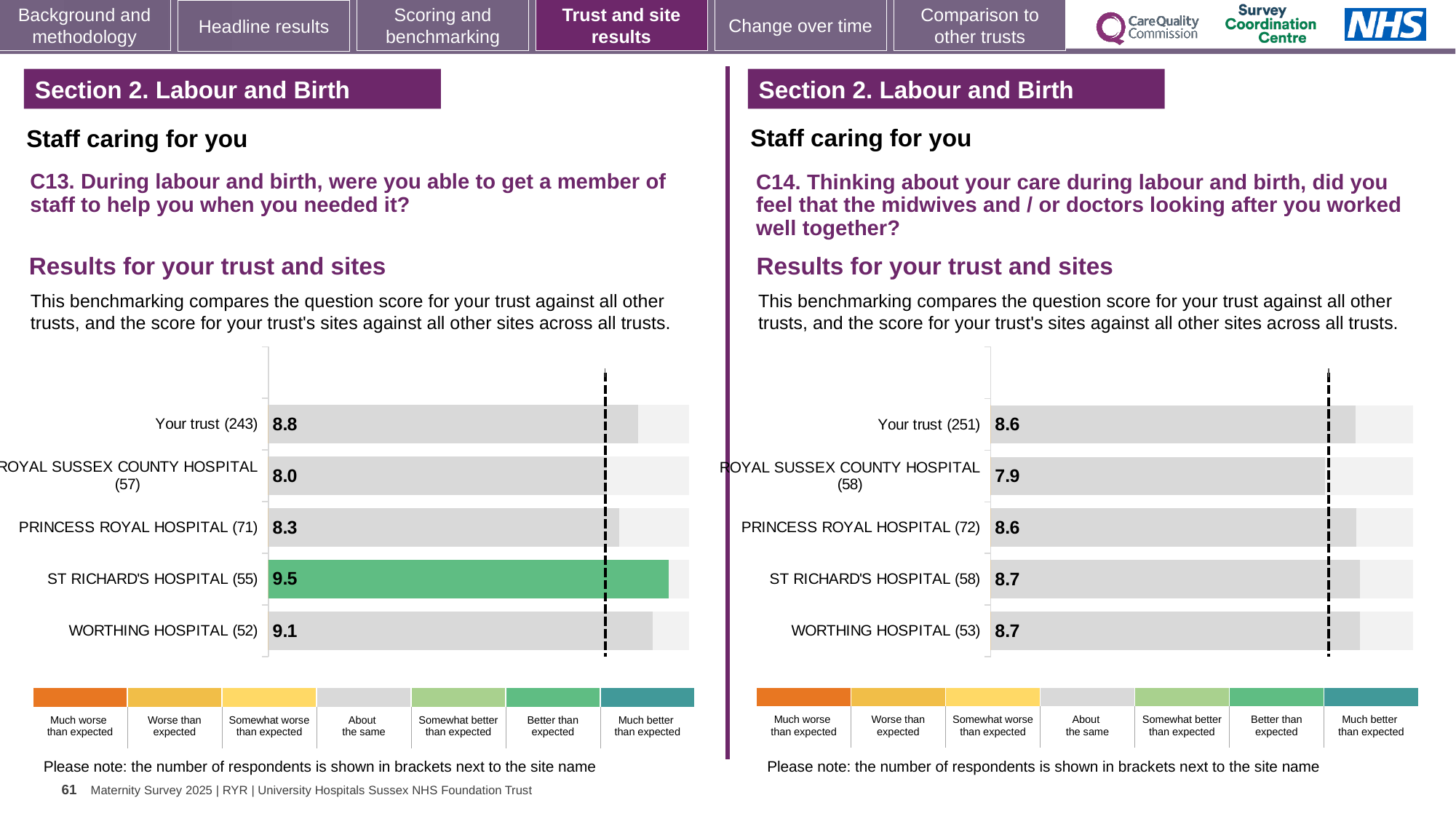
In the C14 chart on the right, what is the score for ROYAL SUSSEX COUNTY HOSPITAL (58)? 7.9 In the C13 chart on the left, what is the difference between the scores for WORTHING HOSPITAL (52) and PRINCESS ROYAL HOSPITAL (71)? 0.8 In the C13 chart on the left, which bar is coloured green rather than grey? ST RICHARD'S HOSPITAL (55) In the C13 chart on the left, which site has the lowest score? ROYAL SUSSEX COUNTY HOSPITAL (57) In the C14 chart on the right, which site has the lowest score? ROYAL SUSSEX COUNTY HOSPITAL (58) In the C14 chart on the right, which is larger: the score for ST RICHARD'S HOSPITAL (58) or PRINCESS ROYAL HOSPITAL (72)? ST RICHARD'S HOSPITAL (58) In the C13 chart on the left, what is the score for ST RICHARD'S HOSPITAL (55)? 9.5 What kind of chart is used in the C13 chart on the left? Bar chart In the C14 chart on the right, what is the score for Your trust (251)? 8.6 In the C13 chart on the left, what is the score for Your trust (243)? 8.8 In the C13 chart on the left, how many bars are plotted? 5 In the C13 chart on the left, which site has the highest score? ST RICHARD'S HOSPITAL (55)